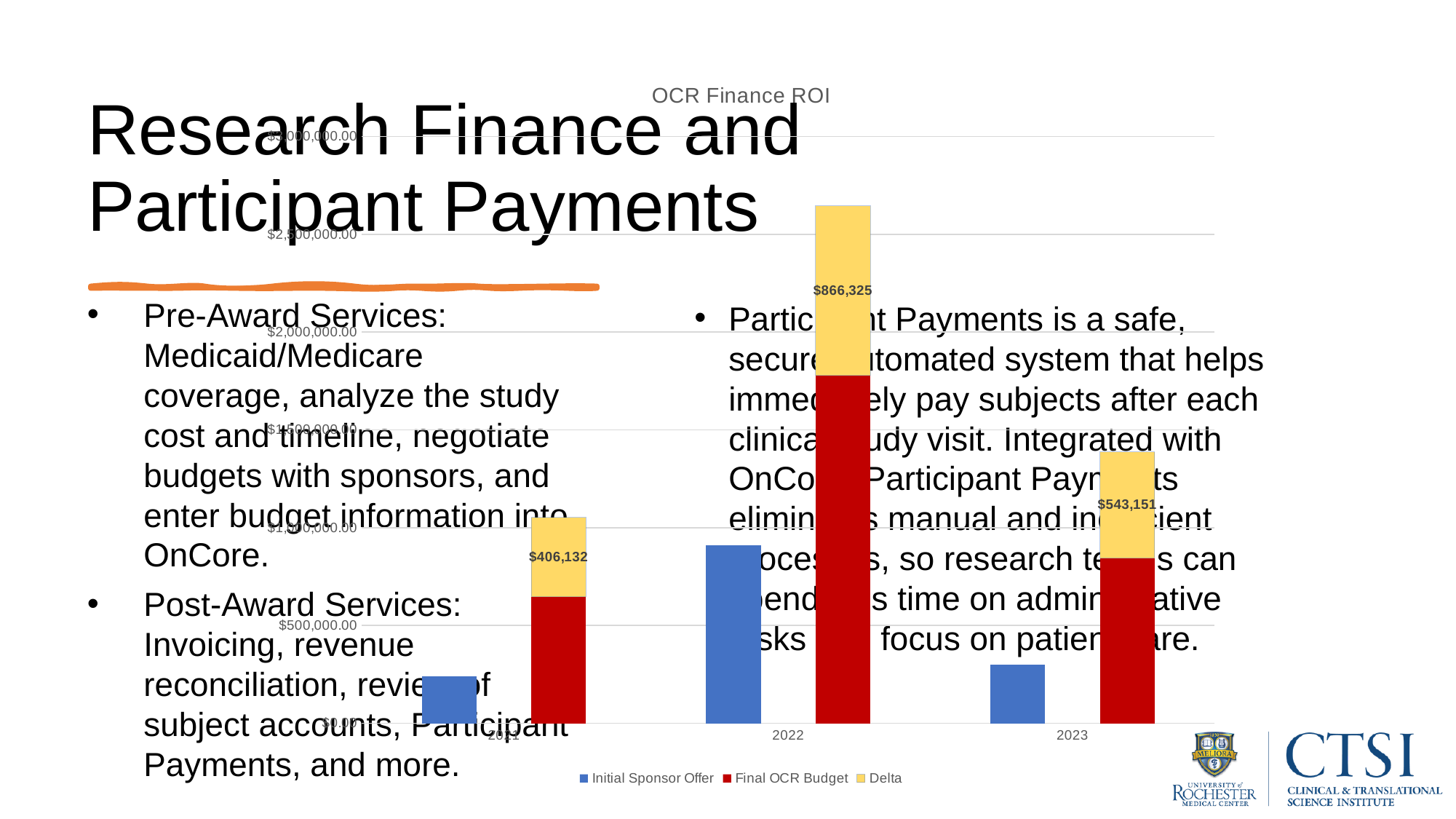
Which year has the highest Delta in the OCR Finance ROI chart? 2022 How many series does the legend of the OCR Finance ROI chart list? 3 What type of chart is the OCR Finance ROI chart? bar chart What is the Delta value for 2021 in the OCR Finance ROI chart? $406,132 What is the Delta value for 2022 in the OCR Finance ROI chart? $866,325 Is the Delta for 2023 larger or smaller than the Delta for 2021? larger What is the difference between the Delta for 2022 and the Delta for 2021? $460,193 Is the Initial Sponsor Offer for 2021 greater or less than $500,000.00? less Which year has the lowest Delta in the OCR Finance ROI chart? 2021 Is the Initial Sponsor Offer for 2022 greater or less than $500,000.00? greater How many years are shown on the x axis of the OCR Finance ROI chart? 3 What is the Delta value for 2023 in the OCR Finance ROI chart? $543,151